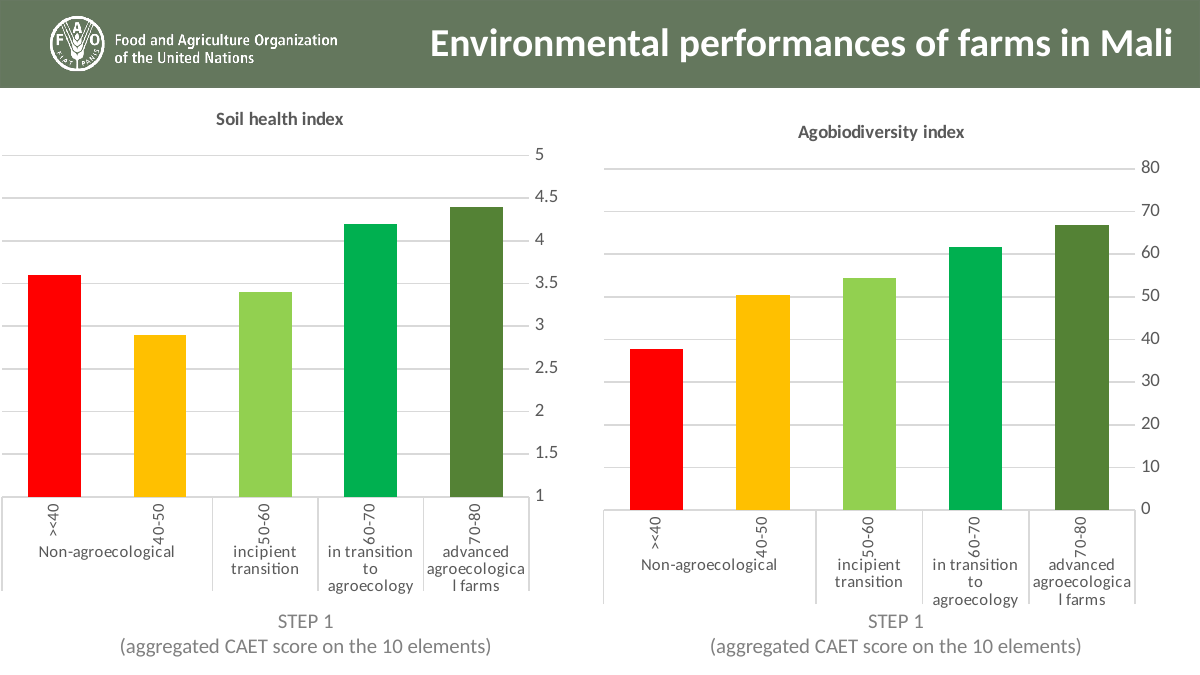
How many categories are shown in the Agobiodiversity index chart? 5 In the Soil health index chart, which is larger: the value for <40 or the value for 40-50? <40 In the Agobiodiversity index chart, do the values rise or fall from left to right across the categories? rise What kind of chart is the Soil health index chart? bar chart In the Soil health index chart, is the value for 40-50 greater or less than 3? less In the Soil health index chart, which category has the lowest value? 40-50 In the Agobiodiversity index chart, is the value for <40 Non-agroecological greater or less than 40? less In the Agobiodiversity index chart, is the value for 70-80 advanced agroecological farms greater or less than 70? less In the Agobiodiversity index chart, which category has the lowest value? <40 Non-agroecological In the Agobiodiversity index chart, which category has the highest value? 70-80 advanced agroecological farms In the Soil health index chart, which category has the highest value? 70-80 advanced agroecological farms